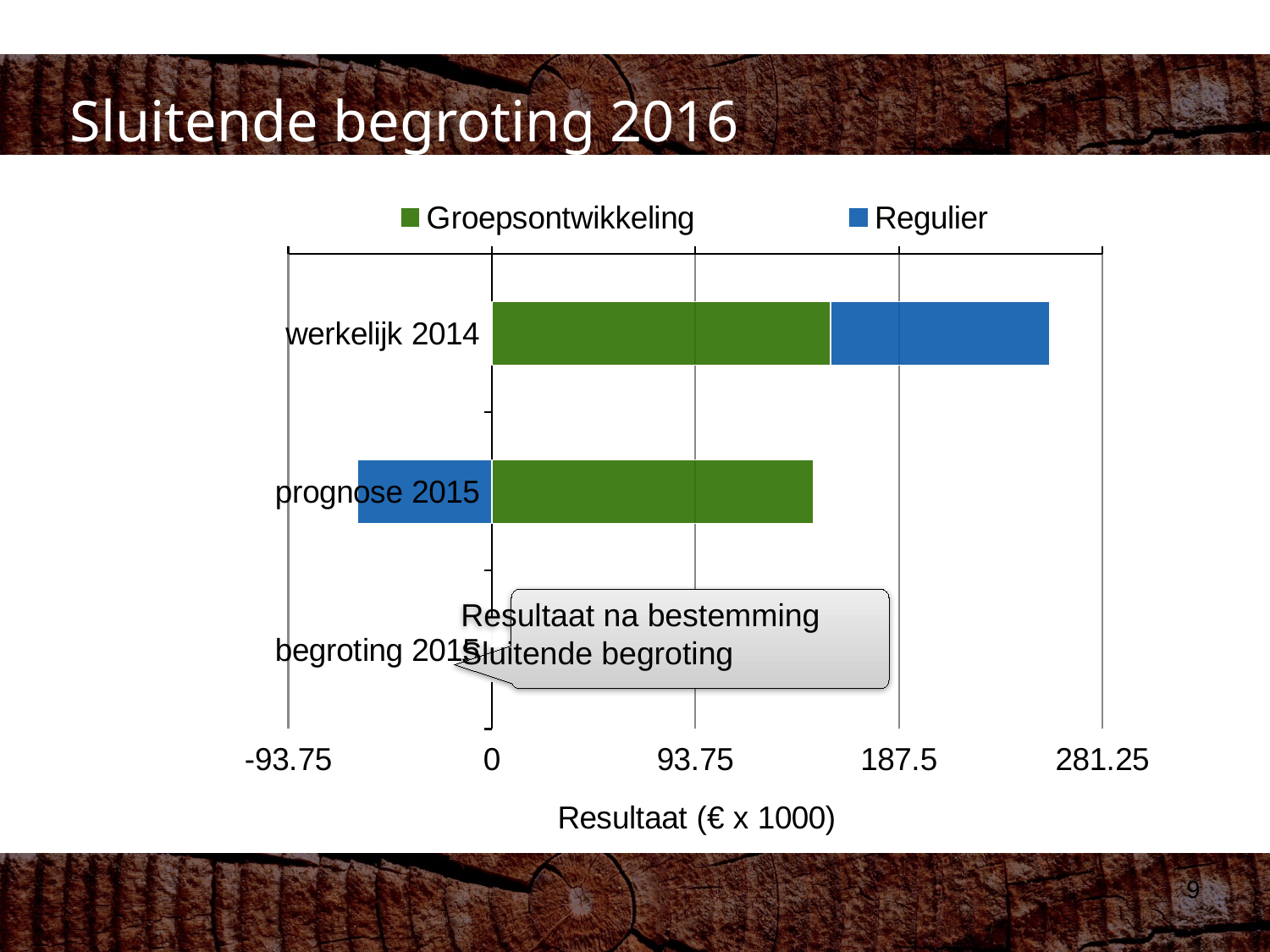
Is the Groepsontwikkeling value for prognose 2015 greater or less than 93.75? greater Which category has the longest total bar? werkelijk 2014 Is the Regulier value for prognose 2015 greater or less than 0? less Is the Groepsontwikkeling value for werkelijk 2014 greater or less than 187.5? less For werkelijk 2014, which series has the larger value, Groepsontwikkeling or Regulier? Groepsontwikkeling Which category has a negative Regulier value? prognose 2015 How many categories are shown on the vertical axis of the chart? 3 What kind of chart is shown on the slide? bar chart What is the label of the horizontal axis? Resultaat (€ x 1000) How many series does the legend list? 2 What is the title of the slide? Sluitende begroting 2016